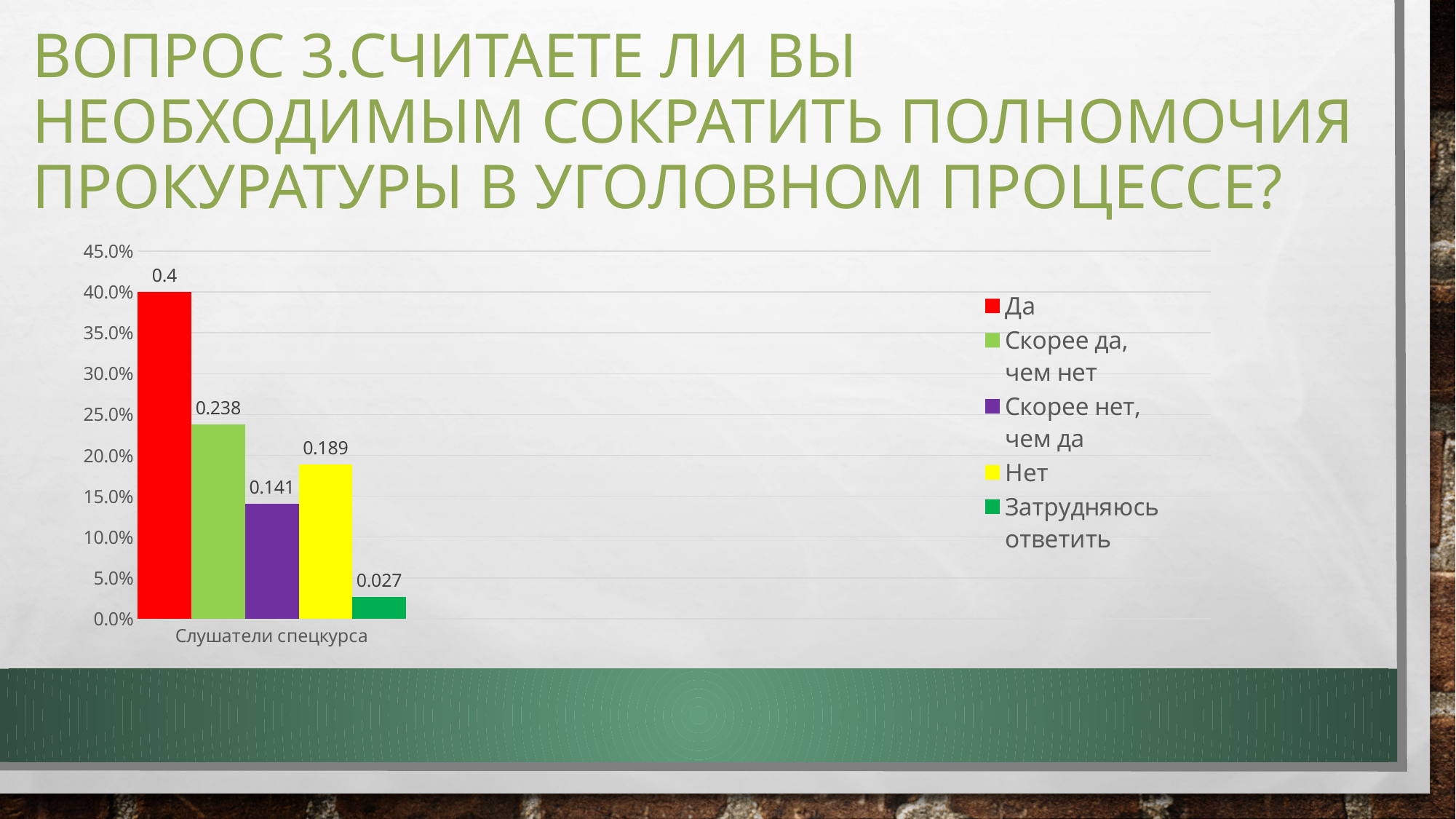
What is the difference between the values for "Да" and "Скорее да, чем нет"? 0.162 What is the value for "Скорее нет, чем да"? 0.141 Which answer option has the highest value? Да Which is larger, the value for "Нет" or the value for "Скорее нет, чем да"? Нет What kind of chart is shown on the slide? Bar chart What is the value for "Скорее да, чем нет"? 0.238 What is the value for "Затрудняюсь ответить"? 0.027 How many series does the legend list? 5 What is the value for "Нет"? 0.189 Which answer option has the lowest value? Затрудняюсь ответить What is the value for "Да" among "Слушатели спецкурса"? 0.4 What is the category label shown on the x axis? Слушатели спецкурса